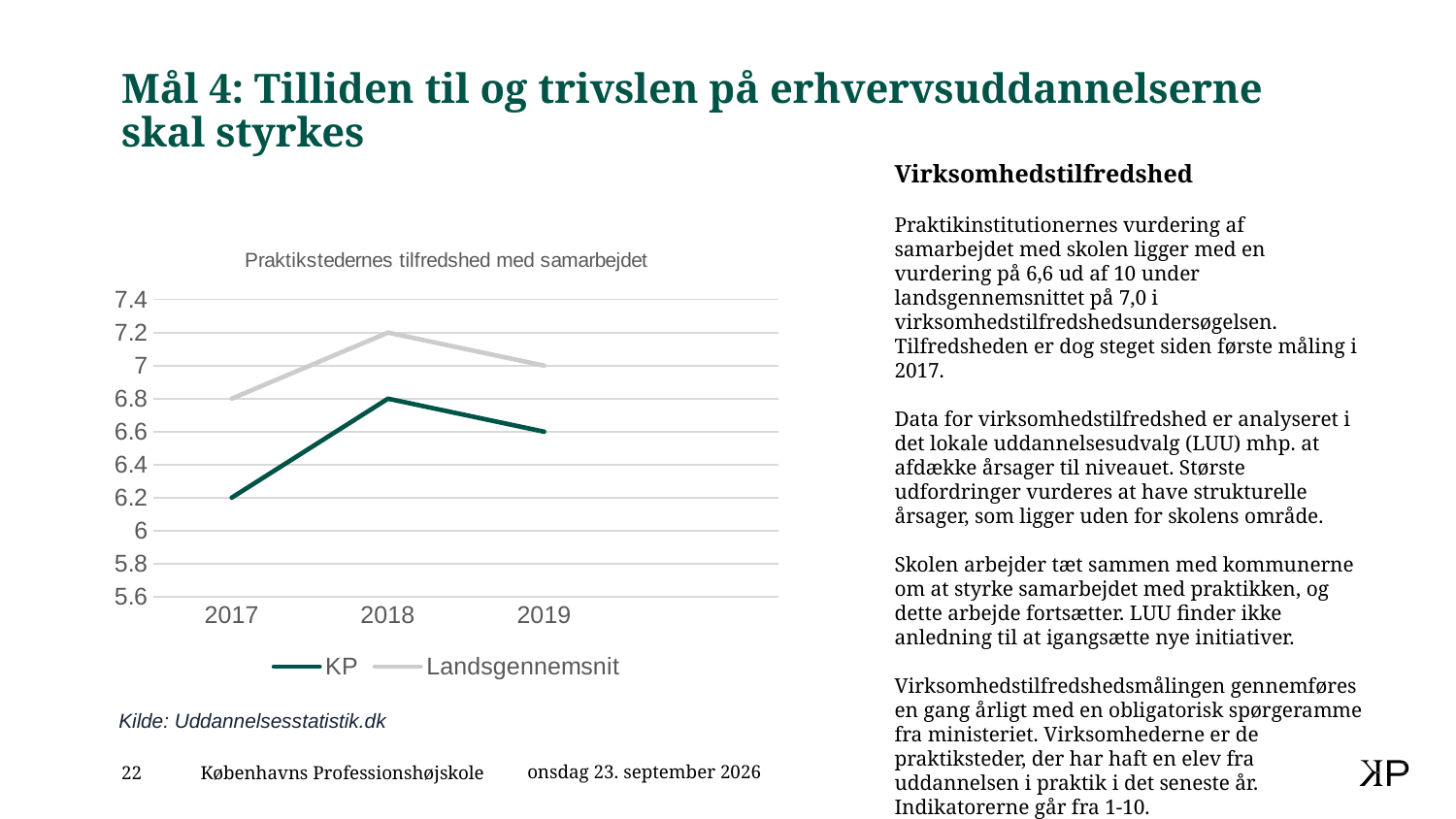
What is the title of the chart? Praktikstedernes tilfredshed med samarbejdet In which year is the KP value highest? 2018 What is the value for KP in 2019? 6.6 Is the value for Landsgennemsnit in 2019 greater or less than 6.8? greater What is the value for KP in 2017? 6.2 In which year is the Landsgennemsnit value lowest? 2017 What type of chart is shown on the slide? line chart How many years are shown on the x axis of the chart? 3 How many series does the chart legend list? 2 What is the value for Landsgennemsnit in 2018? 7.2 What is the value for KP in 2018? 6.8 Which series has the higher value in 2019, KP or Landsgennemsnit? Landsgennemsnit